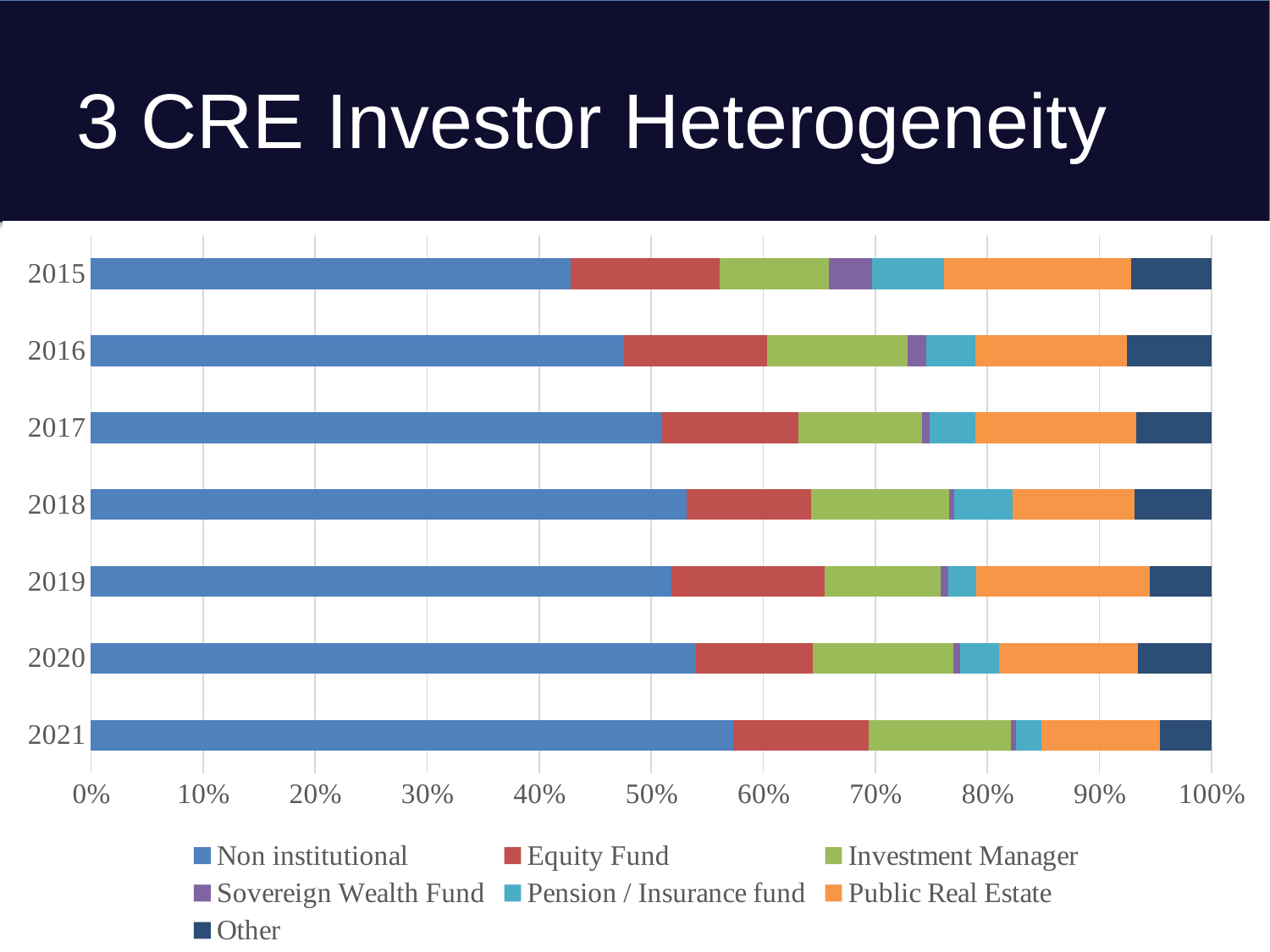
Does the Non institutional share generally rise or fall from 2015 to 2021? rise Which year has the larger Sovereign Wealth Fund share, 2015 or 2021? 2015 What do the segments of each stacked bar add up to? 100% Is the Non institutional share in 2021 greater or less than 50%? greater How many series does the legend list? 7 What kind of chart is shown on the slide? Stacked bar chart Is the Non institutional share in 2015 greater or less than 40%? greater How many years (categories) are plotted on the chart? 7 Which year has the largest Non institutional share? 2021 What is the title of the slide containing the chart? 3 CRE Investor Heterogeneity Is the Non institutional share in 2016 greater or less than 50%? less Which year has the smallest Non institutional share? 2015